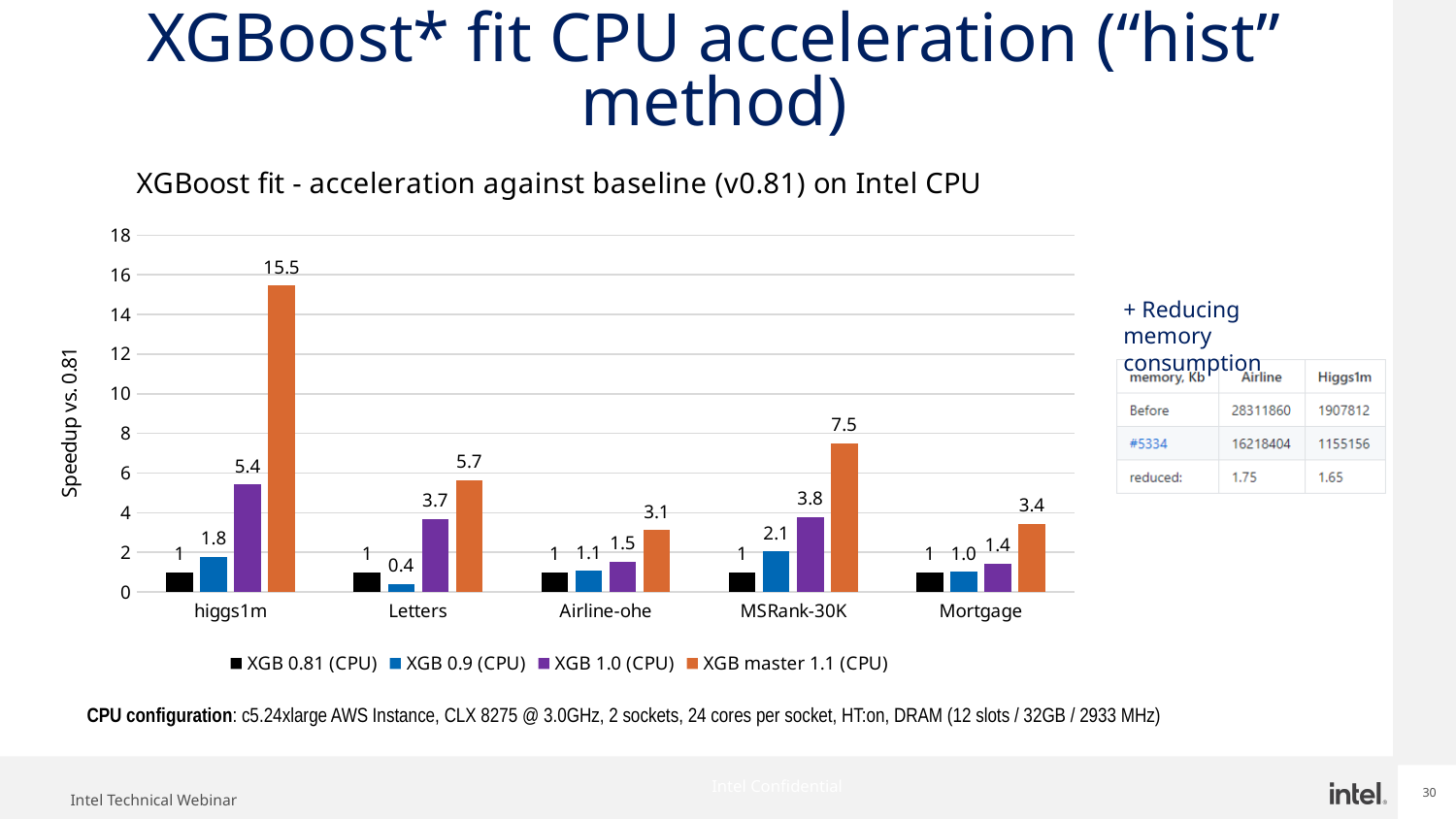
How many datasets are shown on the x axis of the chart? 5 Which dataset has the highest speedup for XGB master 1.1 (CPU)? higgs1m What is the y-axis label of the chart? Speedup vs. 0.81 What is the difference between the XGB master 1.1 (CPU) and XGB 1.0 (CPU) speedups on MSRank-30K? 3.7 Is the XGB master 1.1 (CPU) speedup on higgs1m greater or less than 14? greater What type of chart is shown on the slide? bar chart What is the speedup for XGB 1.0 (CPU) on MSRank-30K? 3.8 Which dataset has the lowest speedup for XGB 1.0 (CPU)? Mortgage What is the speedup for XGB master 1.1 (CPU) on higgs1m? 15.5 Which is larger: the XGB master 1.1 (CPU) speedup on Letters or on Mortgage? Letters What is the speedup for XGB 0.9 (CPU) on Letters? 0.4 How many series does the chart legend list? 4